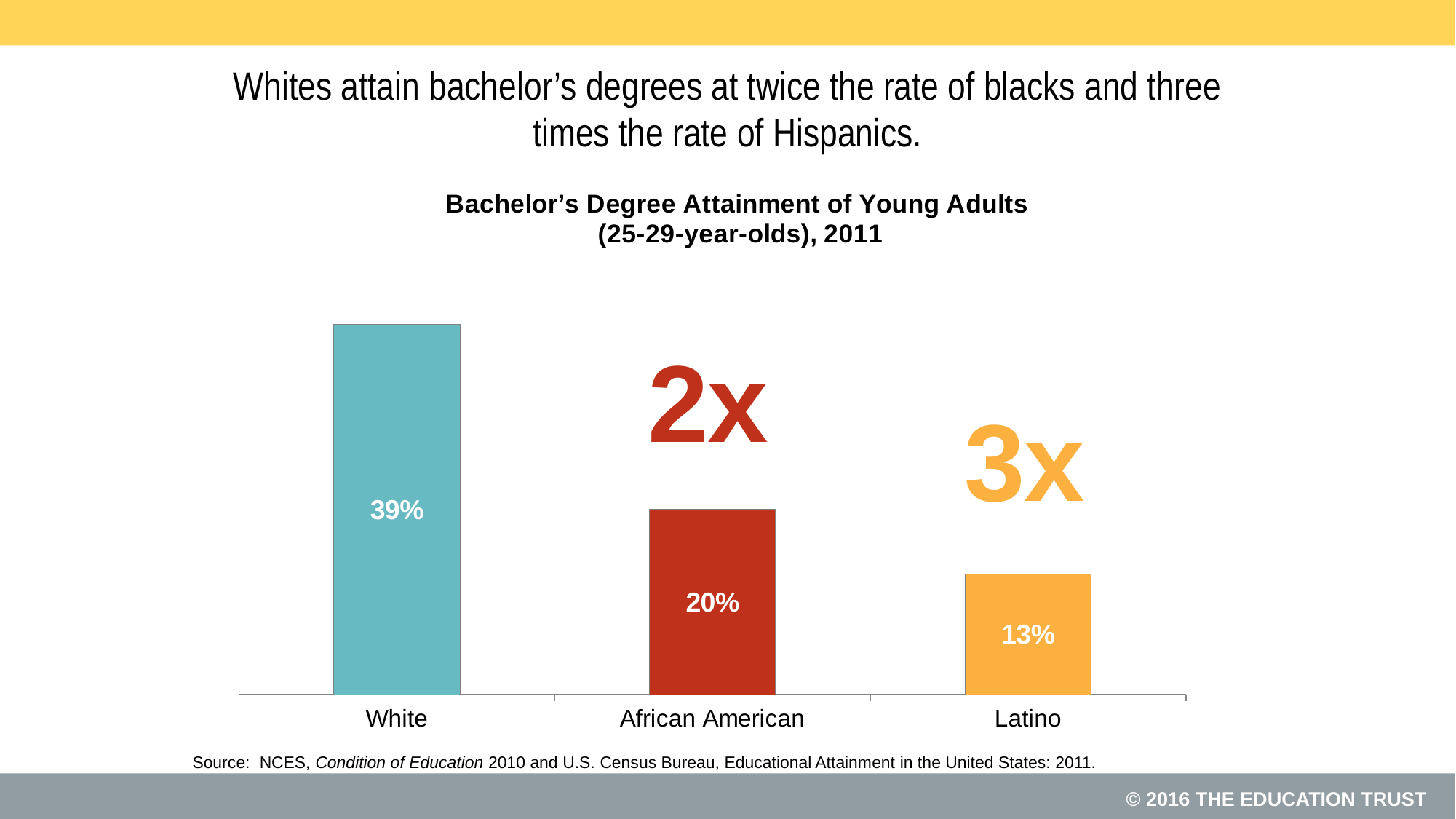
How many groups are shown in the chart? 3 Which group has the highest bachelor's degree attainment rate? White Which group has the lowest bachelor's degree attainment rate? Latino What is the bachelor's degree attainment rate for White young adults? 39% What is the difference in attainment rate between African American and Latino young adults? 7% What is the difference in attainment rate between White and African American young adults? 19% What is the bachelor's degree attainment rate for African American young adults? 20% Which group has a higher attainment rate, African American or Latino? African American What is the bachelor's degree attainment rate for Latino young adults? 13% Do the values rise or fall from left to right across the groups? Fall What kind of chart is shown on the slide? Bar chart What is the title of the chart? Bachelor's Degree Attainment of Young Adults (25-29-year-olds), 2011